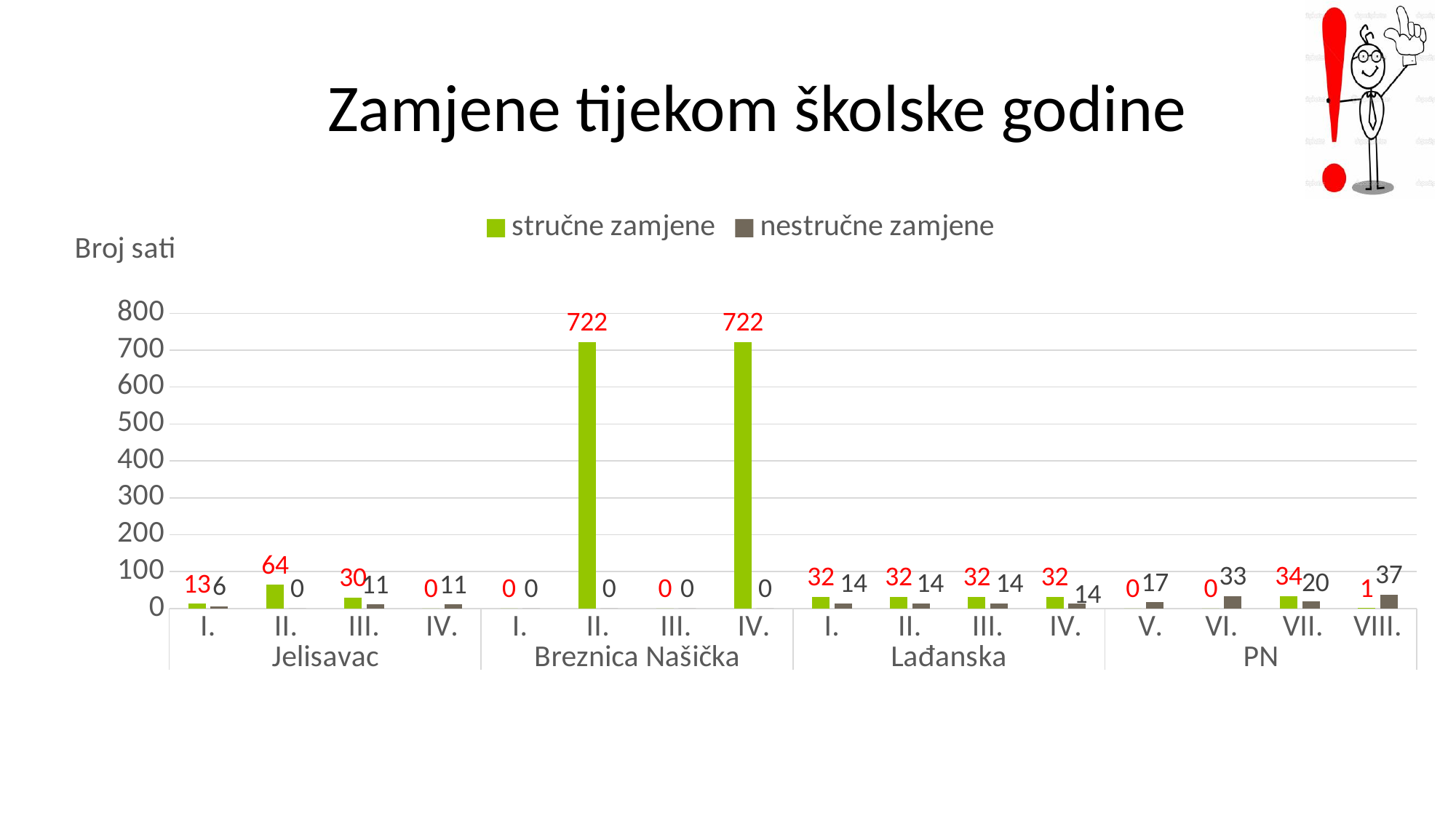
Which category has the highest value of nestručne zamjene? VIII. (PN) What is the label of the y axis? Broj sati What is the title of the chart? Zamjene tijekom školske godine Which is larger for VI. in PN: stručne zamjene or nestručne zamjene? nestručne zamjene How many series does the legend list? 2 What is the value of nestručne zamjene for VIII. in PN? 37 What is the difference between stručne zamjene and nestručne zamjene for VII. in PN? 14 What is the value of nestručne zamjene for III. in Lađanska? 14 What type of chart is shown on the slide? bar chart What is the value of stručne zamjene for II. in Jelisavac? 64 How many categories are shown on the x axis? 16 What is the value of stručne zamjene for II. in Breznica Našička? 722